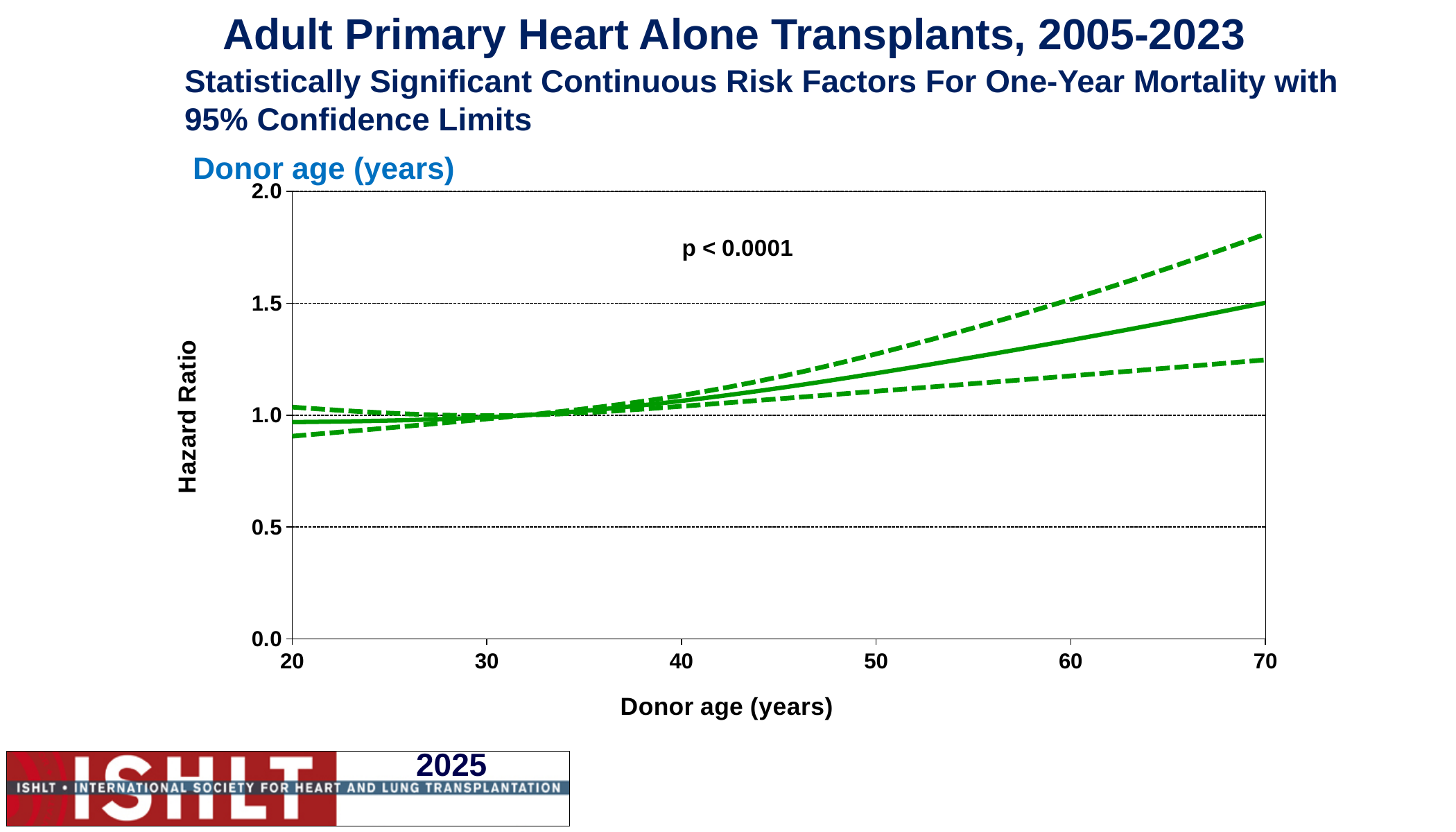
Is the hazard ratio on the solid line at donor age 70 greater or less than 1.0? greater Is the lower dashed confidence limit at donor age 70 greater or less than 1.5? less Is the hazard ratio on the solid line higher at donor age 70 or at donor age 30? 70 What p-value is printed on the chart? p < 0.0001 What is the label of the y axis? Hazard Ratio What kind of chart is shown on the slide? line chart Is the hazard ratio on the solid line at donor age 50 greater or less than 1.0? greater Does the hazard ratio (solid line) rise or fall as donor age increases from 40 to 70 years? rise How many lines are plotted on the chart? 3